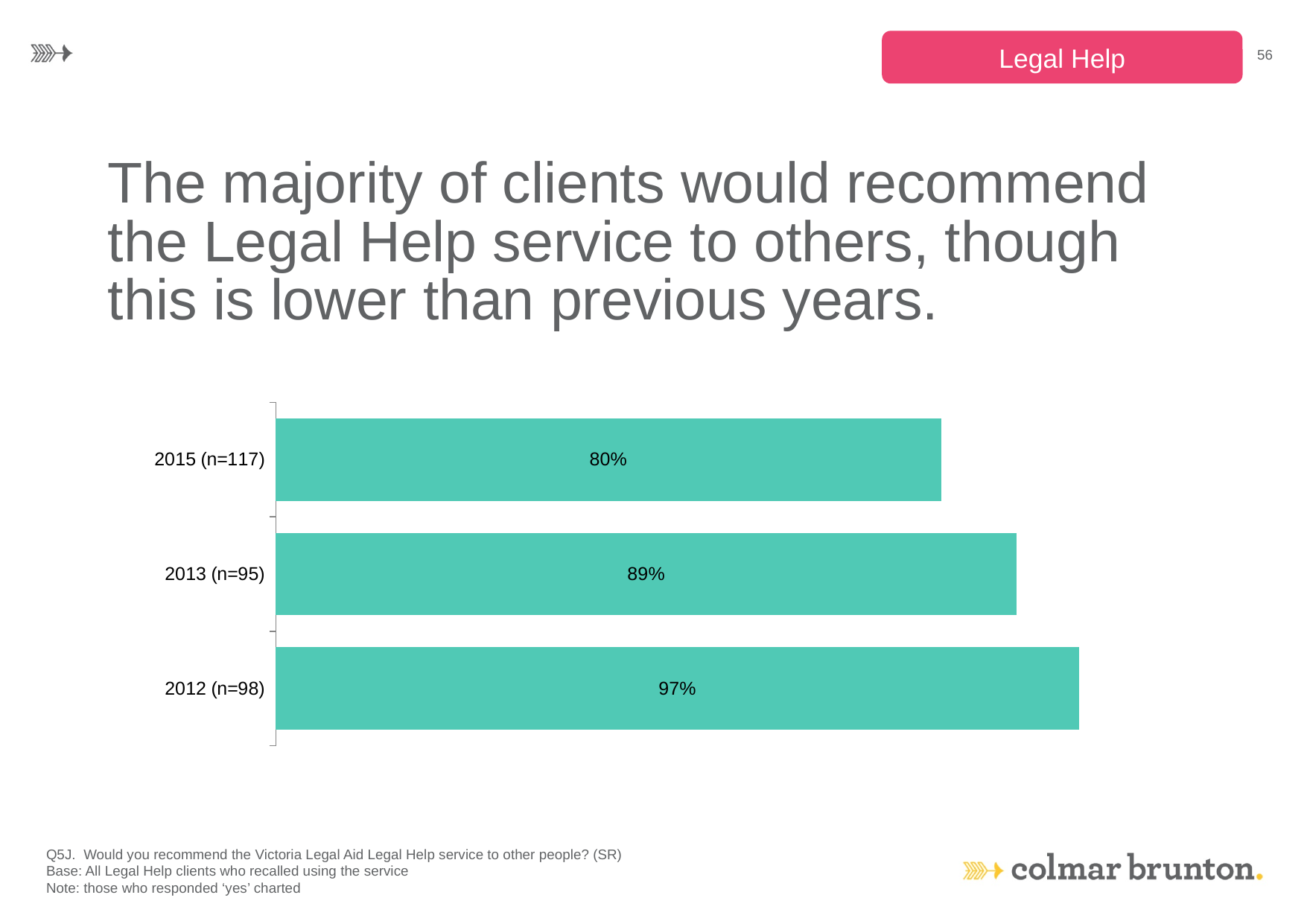
How many years (categories) are shown in the chart? 3 Do the values rise or fall from 2012 to 2015? Fall What percentage of clients would recommend the Legal Help service in 2015 (n=117)? 80% What is the difference in percentage points between 2012 and 2015? 17 What is the difference in percentage points between 2013 and 2015? 9 What is the value shown for 2012 (n=98)? 97% Which year has the highest percentage of clients who would recommend the service? 2012 (n=98) What kind of chart is shown on the slide? Bar chart What is the sample size (n) for the 2015 bar? 117 Which is larger, the value for 2013 or the value for 2015? 2013 Which year has the lowest percentage of clients who would recommend the service? 2015 (n=117) What is the value shown for 2013 (n=95)? 89%